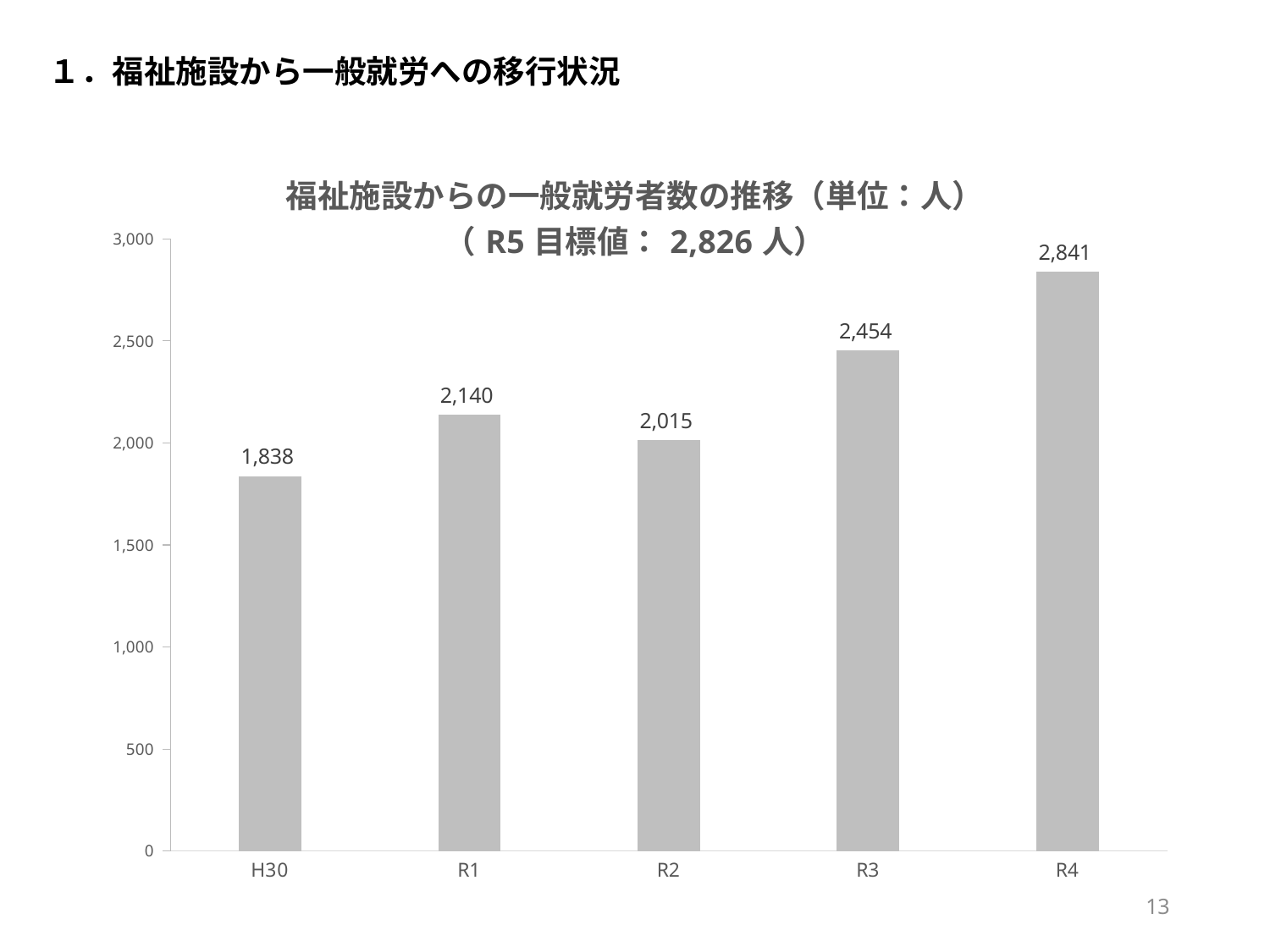
Which category has the highest value? R4 What is the R5 target value stated in the chart title? 2,826 人 How many categories are shown on the x axis? 5 What is the value for R4? 2,841 What is the value for H30? 1,838 What is the difference between the values for R4 and R3? 387 Which category has the lowest value? H30 What kind of chart is shown on the slide? bar chart What is the value for R2? 2,015 What is the difference between the values for R1 and R2? 125 Is the value for R3 greater or less than 2,500? less Which is larger, the value for R1 or the value for R2? R1